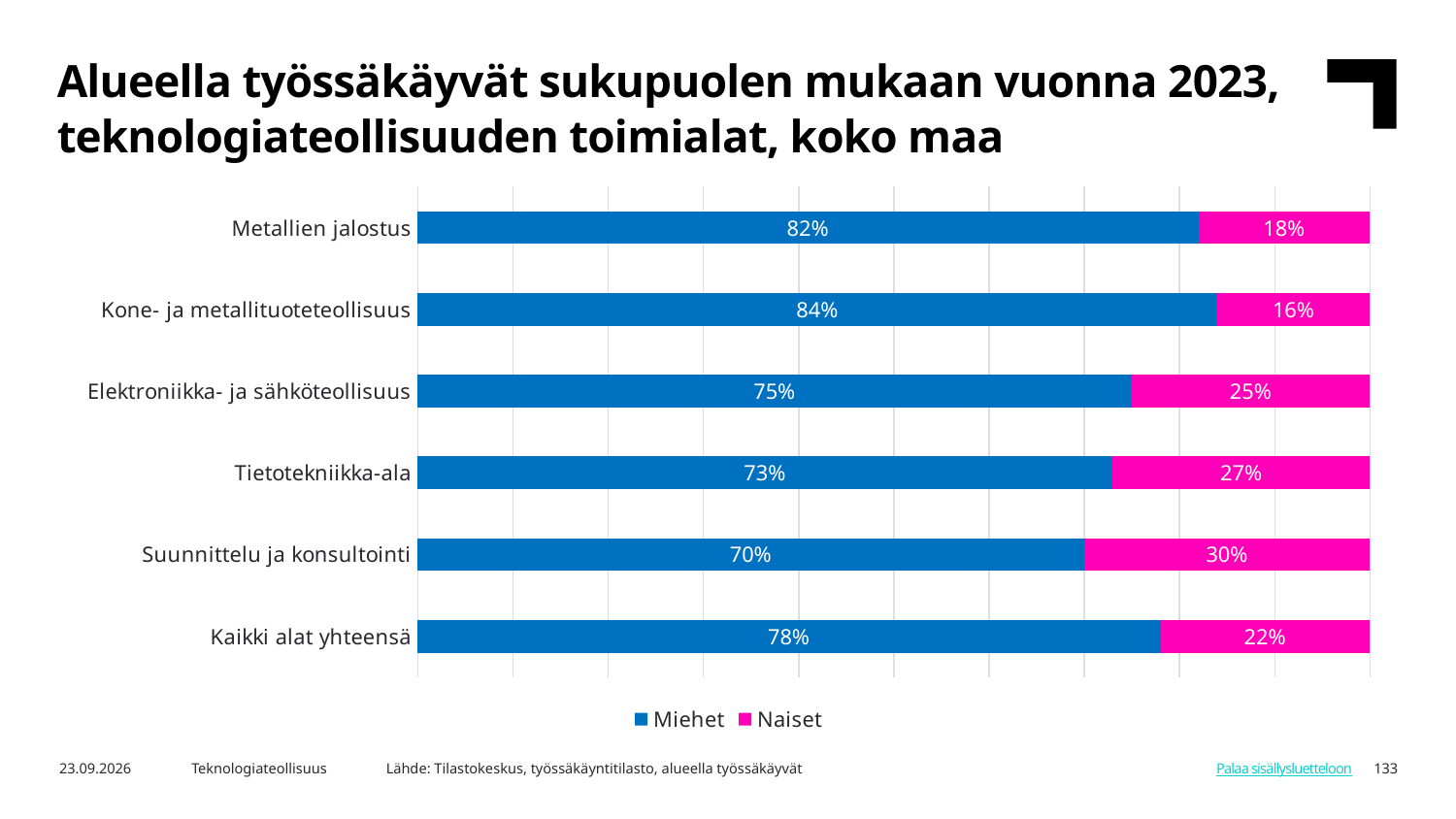
What is the Naiset share for Suunnittelu ja konsultointi? 30% Which has a larger Naiset share, Tietotekniikka-ala or Elektroniikka- ja sähköteollisuus? Tietotekniikka-ala What is the Naiset share for Kaikki alat yhteensä? 22% How many categories are shown on the chart? 6 What is the total of the stacked bar for Tietotekniikka-ala? 100% What is the Miehet share for Metallien jalostus? 82% Which colour represents Naiset in the chart? Pink (magenta) Which category has the highest Miehet share? Kone- ja metallituoteteollisuus What is the difference between the Miehet share for Kone- ja metallituoteteollisuus and for Suunnittelu ja konsultointi? 14% How many series does the legend list? 2 Which category has the lowest Naiset share? Kone- ja metallituoteteollisuus What kind of chart is shown on the slide? Stacked bar chart